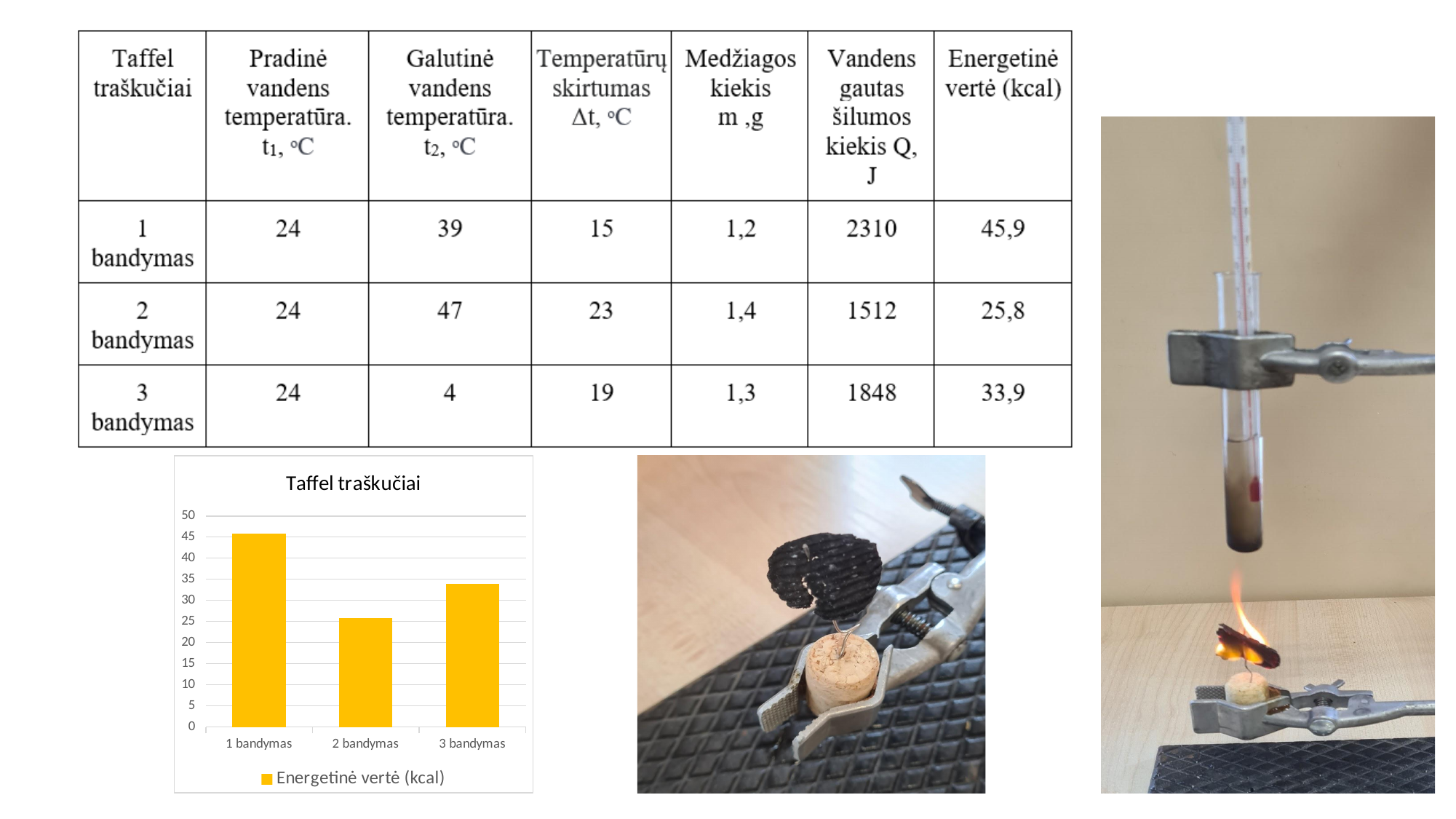
Is the value for 2 bandymas greater or less than 30? less Which bar is taller in the chart, 1 bandymas or 3 bandymas? 1 bandymas How many categories are plotted on the x axis of the chart? 3 Which bar is taller in the chart, 2 bandymas or 3 bandymas? 3 bandymas Which category has the highest bar in the chart? 1 bandymas Is the value for 1 bandymas greater or less than 40? greater Is the value for 3 bandymas greater or less than 30? greater What is the title of the chart? Taffel traškučiai What series name is shown in the chart's legend? Energetinė vertė (kcal) What kind of chart is shown on the slide? bar chart How many series does the chart's legend list? 1 Which category has the lowest bar in the chart? 2 bandymas